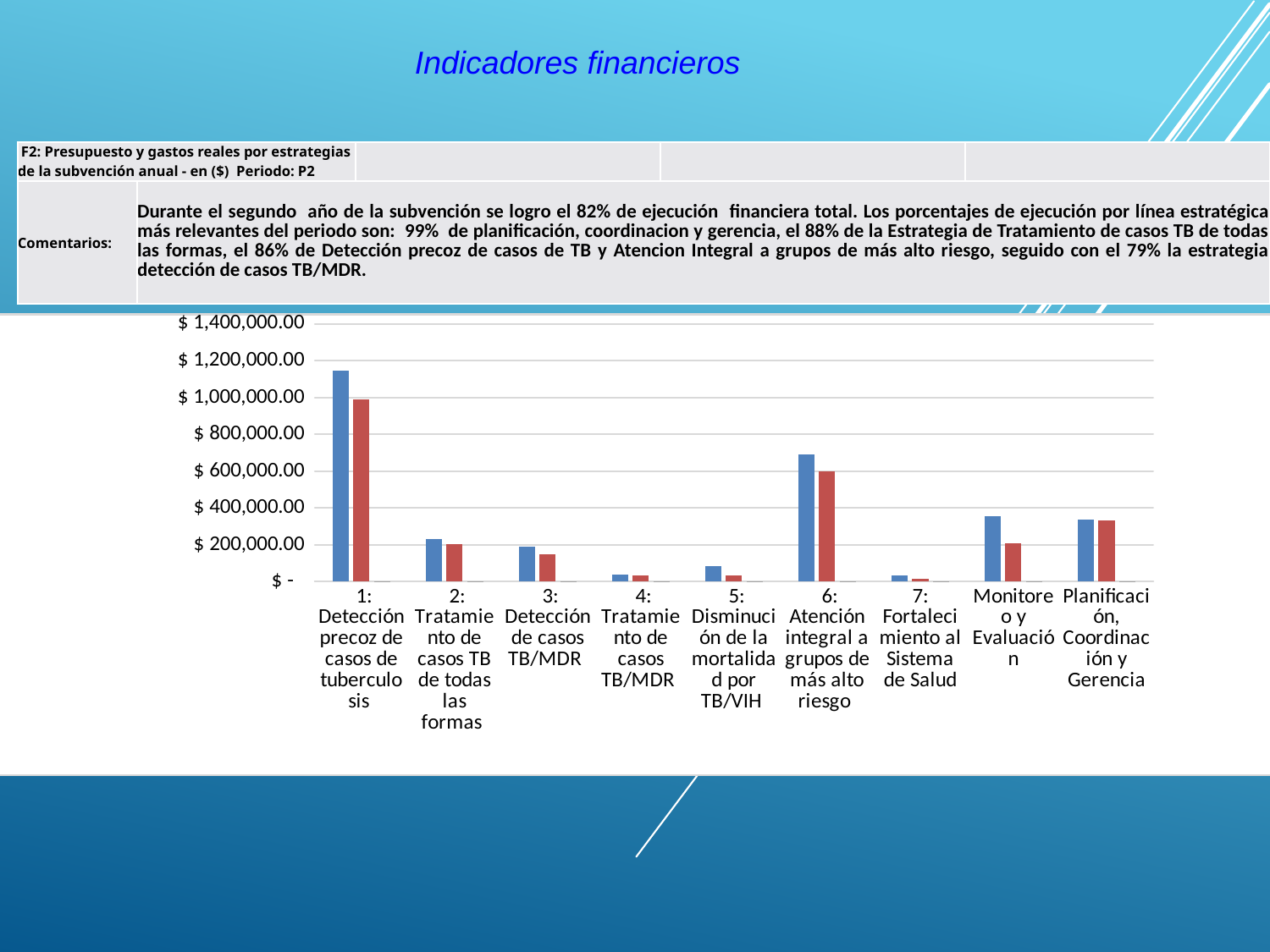
Which category has the shortest red bar in the chart? 7: Fortalecimiento al Sistema de Salud Is the blue bar for '1: Detección precoz de casos de tuberculosis' greater or less than $ 1,000,000.00? greater What kind of chart is shown on the slide? bar chart How many categories are shown along the x axis of the chart? 9 Is the red bar for '3: Detección de casos TB/MDR' greater or less than $ 200,000.00? less Is the blue bar for 'Planificación, Coordinación y Gerencia' greater or less than $ 400,000.00? less What is the highest value labelled on the y axis of the chart? $ 1,400,000.00 Which category has the tallest blue bar in the chart? 1: Detección precoz de casos de tuberculosis Which has the larger red bar: 'Monitoreo y Evaluación' or 'Planificación, Coordinación y Gerencia'? Planificación, Coordinación y Gerencia Which has the larger blue bar: '1: Detección precoz de casos de tuberculosis' or '6: Atención integral a grupos de más alto riesgo'? 1: Detección precoz de casos de tuberculosis